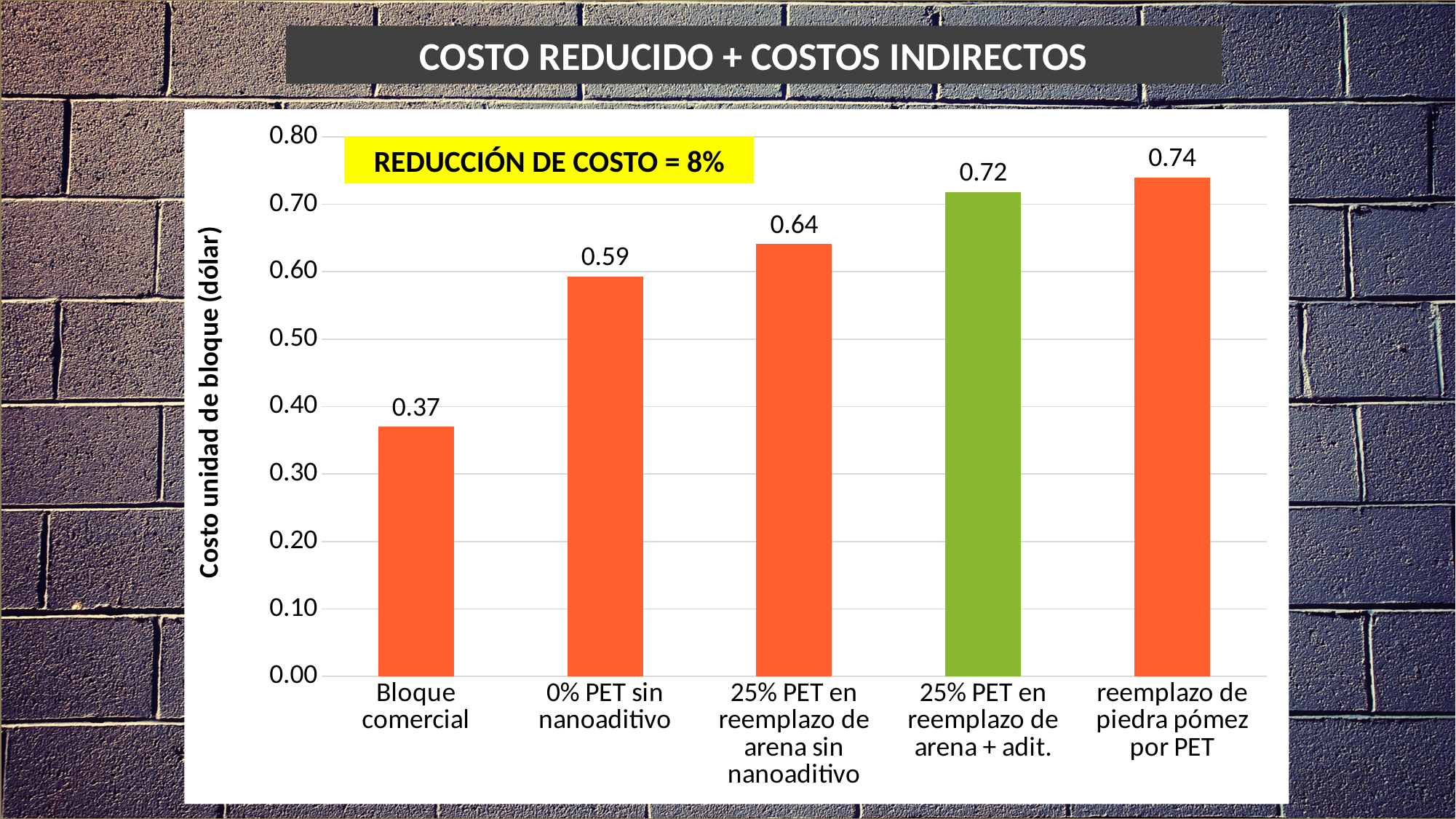
What kind of chart is shown on the slide? Bar chart Which category has the lowest cost per block unit? Bloque comercial What is the value shown for '25% PET en reemplazo de arena + adit.'? 0.72 What is the value shown for 'reemplazo de piedra pómez por PET'? 0.74 How many categories are shown on the x axis? 5 Which category's bar is coloured green instead of orange? 25% PET en reemplazo de arena + adit. Do the values rise or fall from left to right along the x axis? Rise Which is larger: the value for '0% PET sin nanoaditivo' or the value for '25% PET en reemplazo de arena sin nanoaditivo'? 25% PET en reemplazo de arena sin nanoaditivo What is the difference between the value for '25% PET en reemplazo de arena + adit.' and the value for '25% PET en reemplazo de arena sin nanoaditivo'? 0.08 What is the difference between the value for 'reemplazo de piedra pómez por PET' and the value for 'Bloque comercial'? 0.37 What is the cost per block unit for 'Bloque comercial'? 0.37 Which category has the highest cost per block unit? reemplazo de piedra pómez por PET